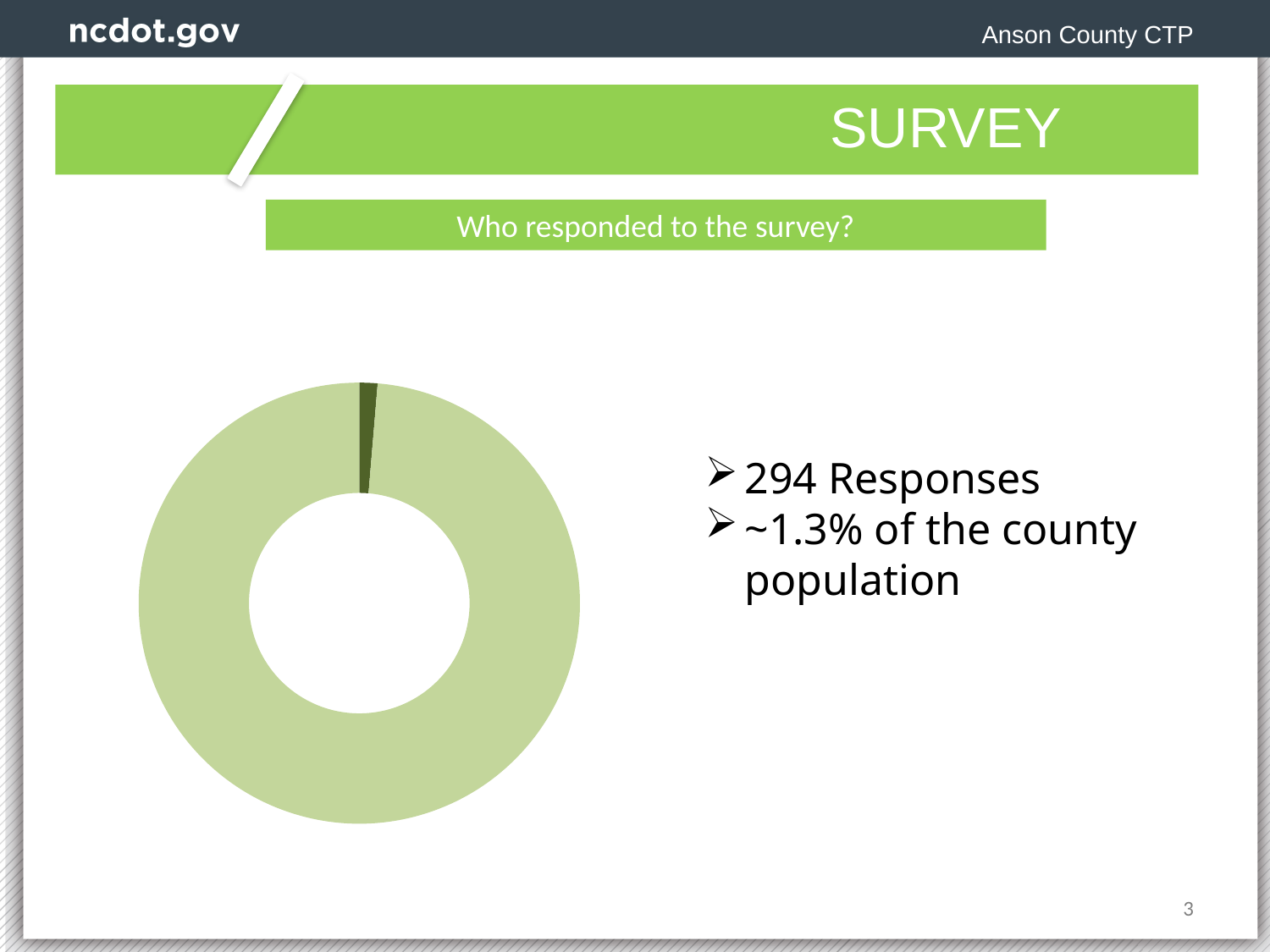
Does the doughnut chart have a legend? No What kind of chart is shown on the slide? doughnut chart Which slice of the doughnut chart is larger, the light green slice or the dark green slice? the light green slice How many slices does the doughnut chart have? 2 What question is posed in the green banner above the chart? Who responded to the survey? Which slice of the doughnut chart is the smallest? the dark green slice